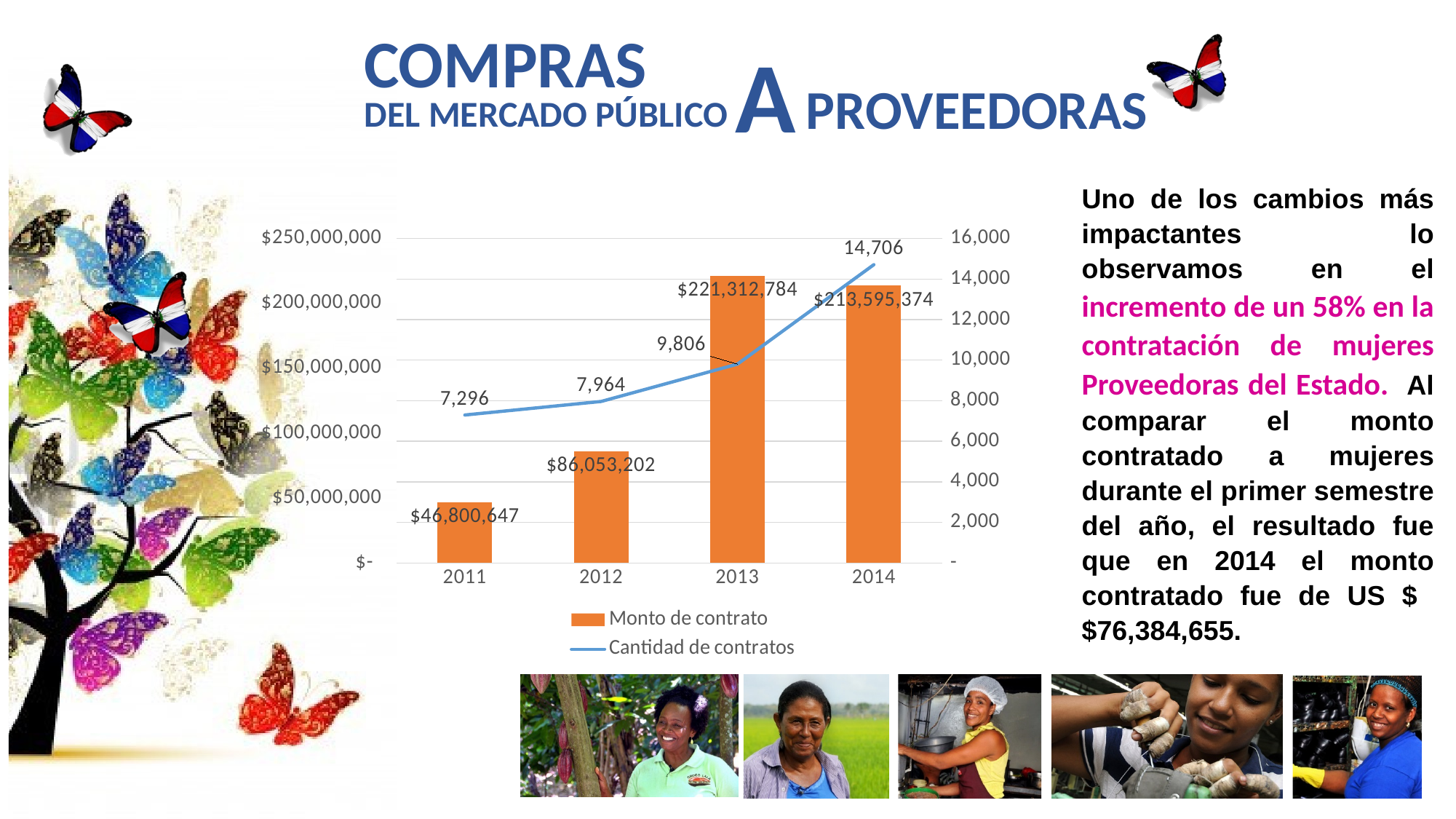
Which year has the lowest Cantidad de contratos? 2011 Is the Monto de contrato for 2012 greater or less than $100,000,000? less What is the Monto de contrato value for 2011? $46,800,647 What is the Cantidad de contratos value for 2014? 14,706 Which year has the highest Monto de contrato? 2013 How many years are shown on the x axis of the chart? 4 Is the Monto de contrato for 2012 larger or smaller than for 2014? smaller What is the Monto de contrato value for 2013? $221,312,784 What is the difference in Cantidad de contratos between 2014 and 2013? 4,900 What is the Cantidad de contratos value for 2012? 7,964 Does the Cantidad de contratos line rise or fall from 2011 to 2014? rise How many series does the chart legend list? 2